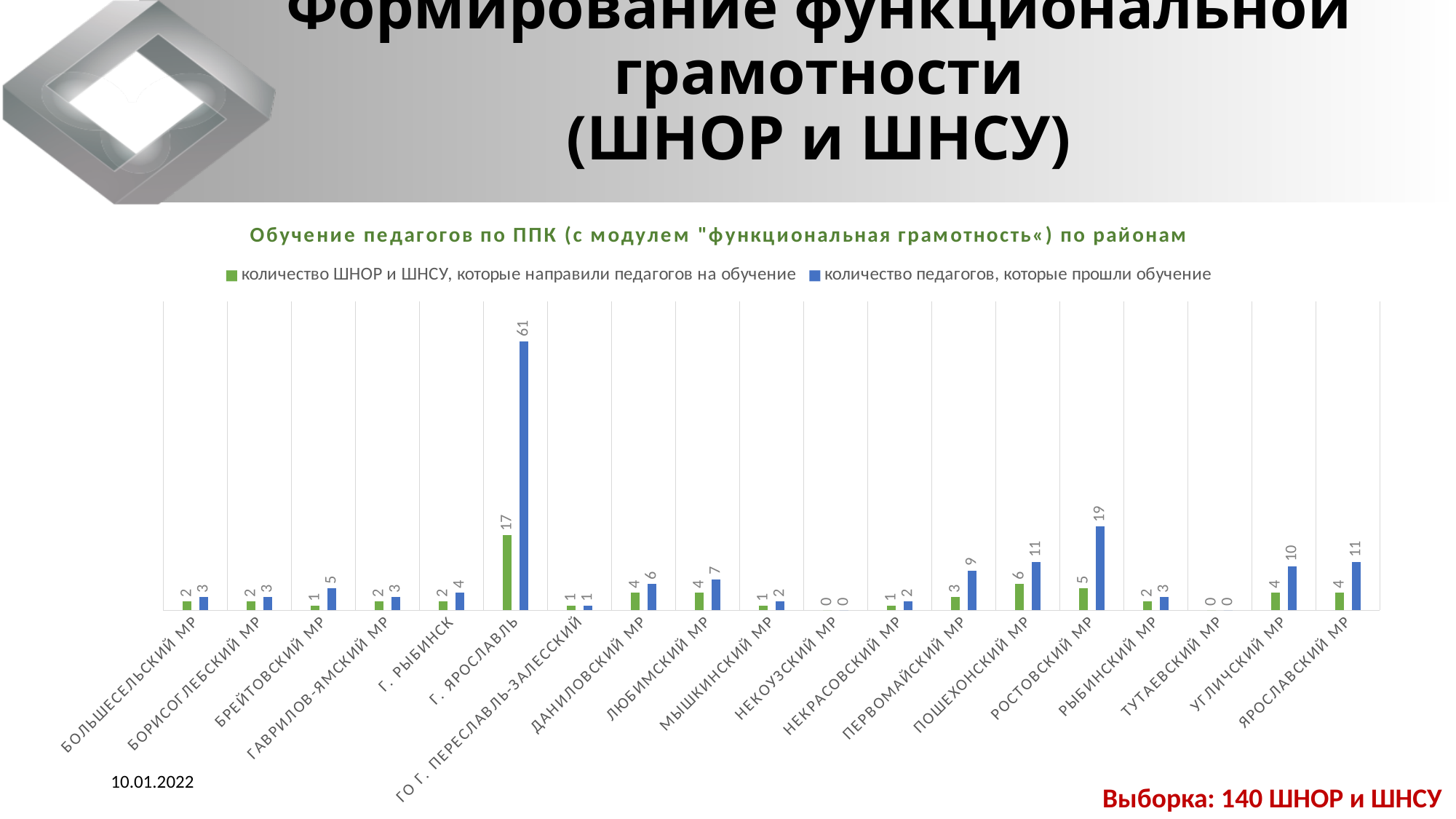
How many педагогов прошли обучение in Брейтовский МР? 5 How many districts (categories) are shown on the x axis? 19 Which districts have a value of 0 for both series? Некоузский МР and Тутаевский МР What kind of chart is shown on the slide? bar chart What is the difference between the two series values for г. Ярославль? 44 Which is larger: the number of педагогов, которые прошли обучение in Первомайский МР or in Любимский МР? Первомайский МР How many series does the legend list? 2 What is the value of 'количество ШНОР и ШНСУ, которые направили педагогов на обучение' for Пошехонский МР? 6 How many педагогов прошли обучение in г. Ярославль? 61 Which district has the highest number of педагогов, которые прошли обучение? г. Ярославль What is the difference between the number of педагогов, которые прошли обучение in Ростовский МР and in Угличский МР? 9 What is the title of the chart? Обучение педагогов по ППК (с модулем "функциональная грамотность«) по районам